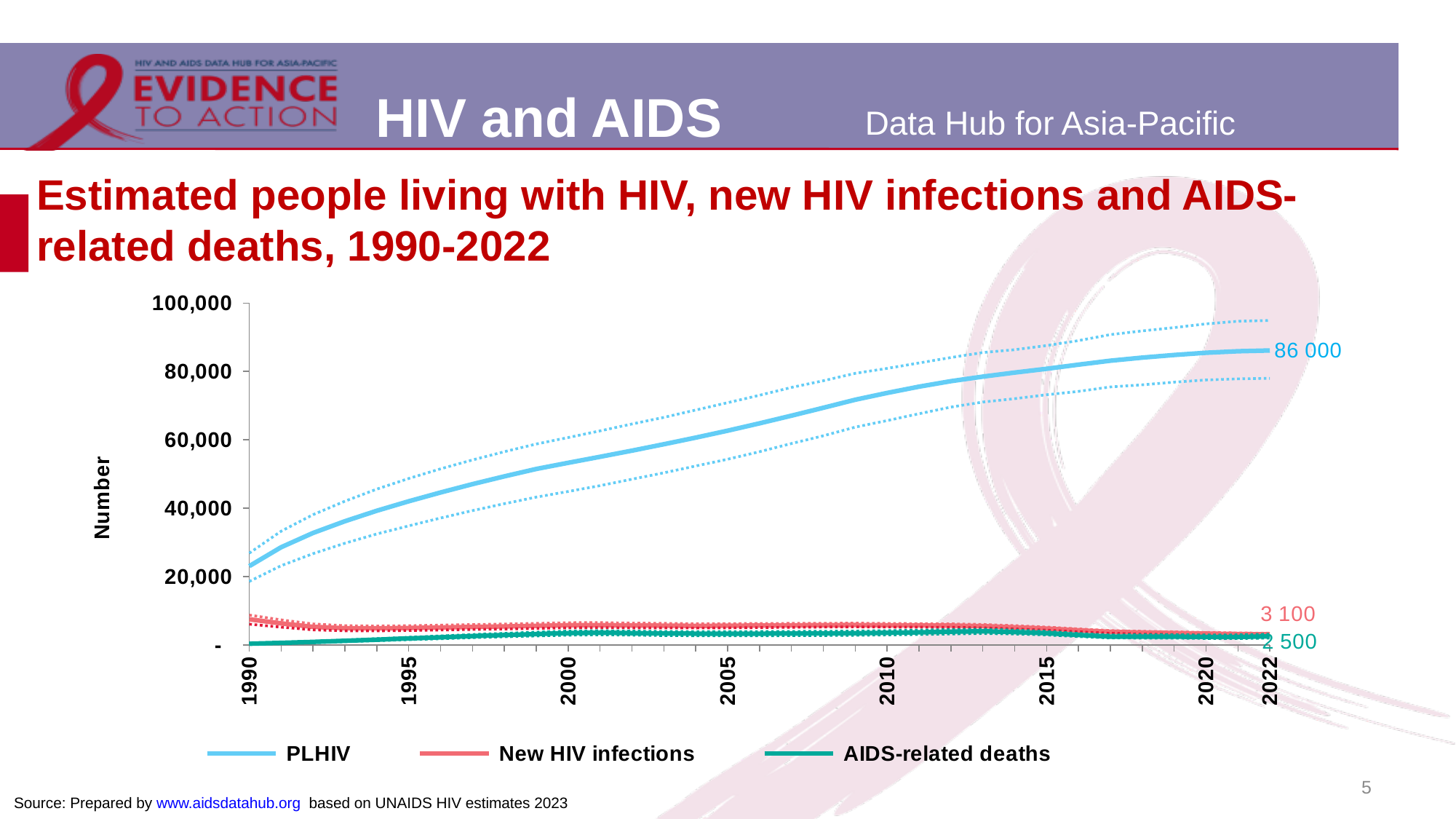
What kind of chart is shown on the slide? Line chart Which series has the highest value in 2022? PLHIV What is the labelled value of New HIV infections in 2022? 3 100 Does the PLHIV line rise or fall from 1990 to 2022? Rise What is the labelled value of AIDS-related deaths in 2022? 2 500 What is the difference between the 2022 values for PLHIV and New HIV infections? 82 900 Is the PLHIV value in 1990 greater or less than 40,000? less What is the difference between the 2022 values for New HIV infections and AIDS-related deaths? 600 What is the labelled value of PLHIV in 2022? 86 000 In 2022, which is larger: New HIV infections or AIDS-related deaths? New HIV infections Is the PLHIV value in 2010 greater or less than 60,000? greater How many series does the legend list? 3